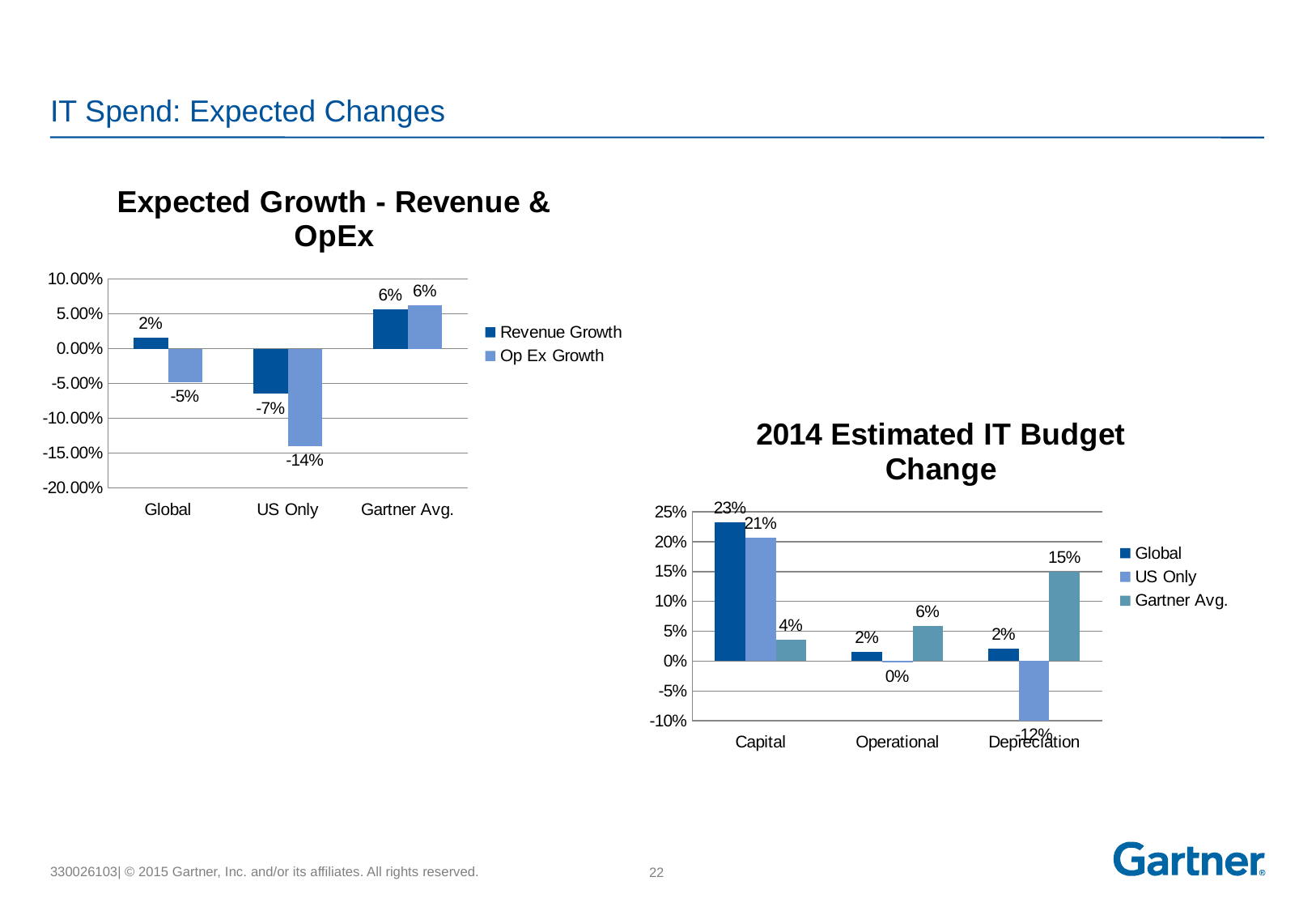
In the 'Expected Growth - Revenue & OpEx' chart, what is the Op Ex Growth value for US Only? -14% In the '2014 Estimated IT Budget Change' chart, is the Gartner Avg. value for Operational larger or smaller than the Global value for Operational? larger In the '2014 Estimated IT Budget Change' chart, what is the Global value for Capital? 23% In the '2014 Estimated IT Budget Change' chart, what is the difference between the Global and US Only values for Capital? 2 percentage points In the 'Expected Growth - Revenue & OpEx' chart, what is the Revenue Growth value for Global? 2% In the 'Expected Growth - Revenue & OpEx' chart, what is the difference between Revenue Growth and Op Ex Growth for Global? 7 percentage points What type of chart is the '2014 Estimated IT Budget Change' chart? Bar chart In the '2014 Estimated IT Budget Change' chart, which series has the highest value for Depreciation? Gartner Avg. In the '2014 Estimated IT Budget Change' chart, what is the US Only value for Depreciation? -12% In the 'Expected Growth - Revenue & OpEx' chart, which category has the lowest Revenue Growth? US Only In the 'Expected Growth - Revenue & OpEx' chart, how many series does the legend list? 2 In the '2014 Estimated IT Budget Change' chart, how many categories are shown on the x axis? 3